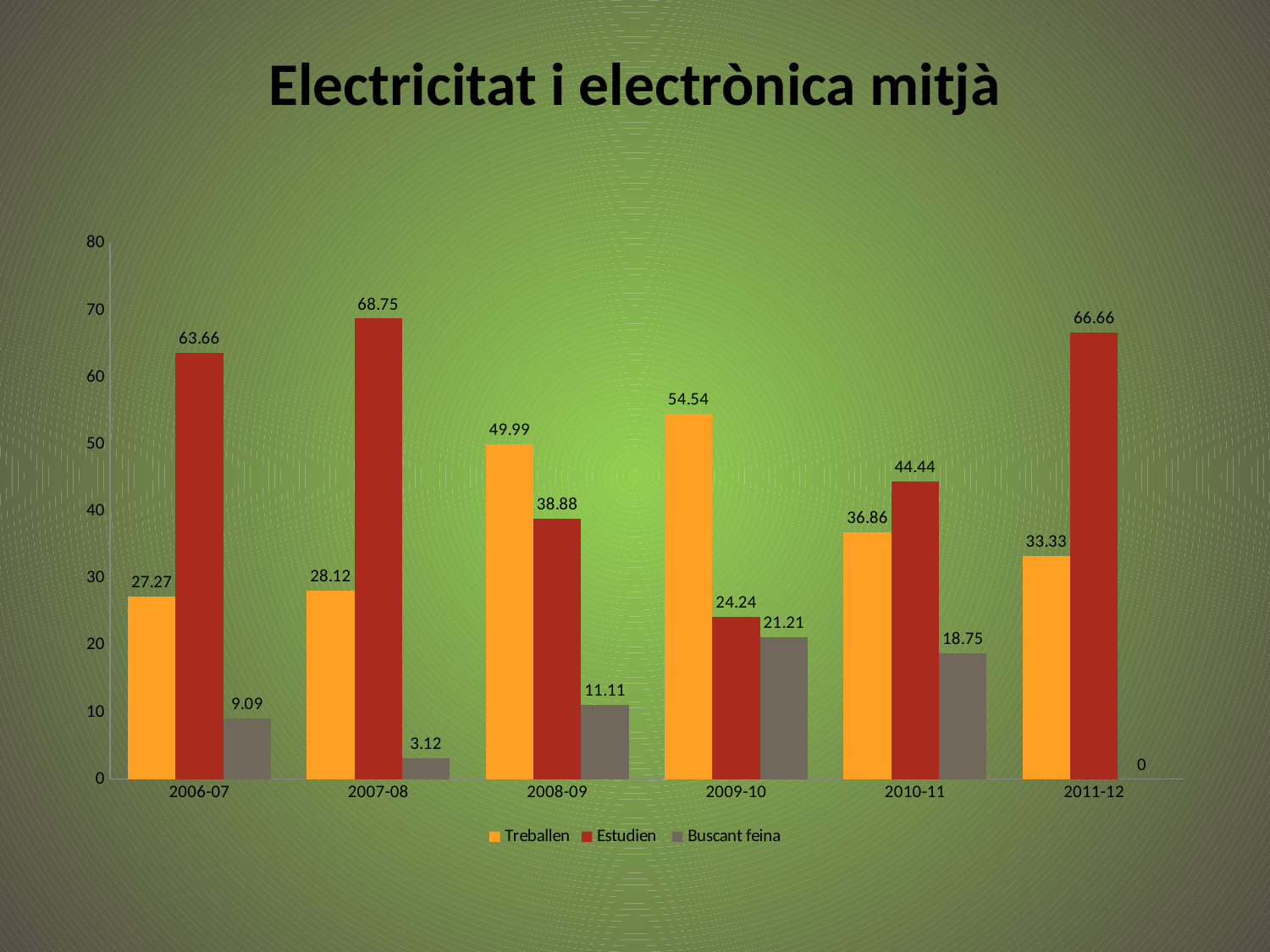
How many years are shown on the x axis? 6 In 2010-11, which is larger: Treballen or Estudien? Estudien What kind of chart is shown on the slide? bar chart How many series does the legend list? 3 Which year has the lowest value for Buscant feina? 2011-12 Is the value for Estudien in 2008-09 greater or less than 40? less What is the value for Treballen in 2009-10? 54.54 What is the difference between Estudien and Treballen in 2006-07? 36.39 What is the title of the chart? Electricitat i electrònica mitjà What is the value for Estudien in 2007-08? 68.75 What is the value for Buscant feina in 2011-12? 0 Which year has the highest value for Treballen? 2009-10